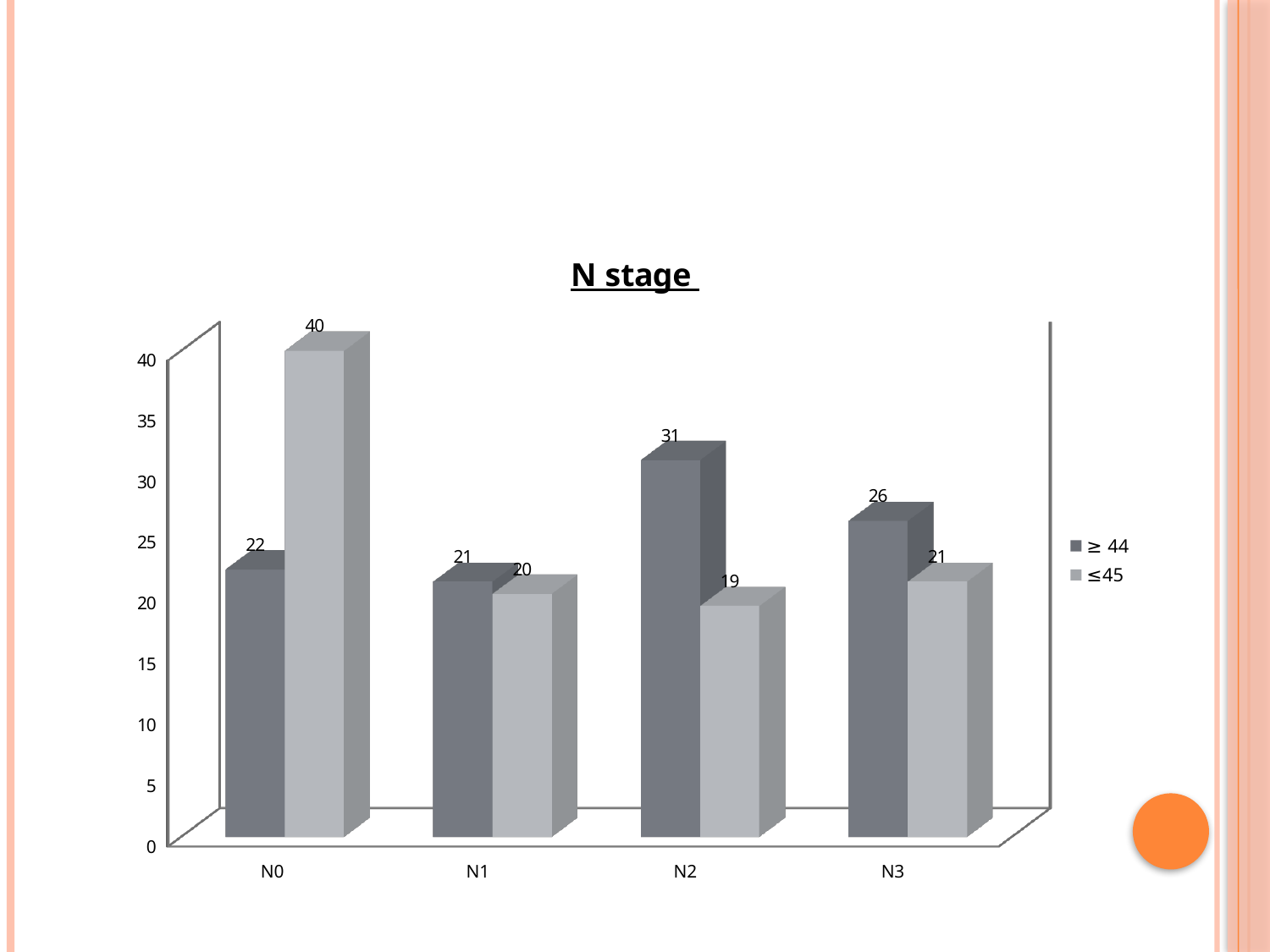
What is the value for N2 in the ≥ 44 series? 31 What is the value for N0 in the ≤45 series? 40 Which category has the highest value in the ≤45 series? N0 What is the difference between the ≤45 and ≥ 44 values for N0? 18 Which is larger for N2: the ≥ 44 value or the ≤45 value? ≥ 44 How many series does the legend list? 2 What kind of chart is shown on the slide? Bar chart What is the value for N0 in the ≥ 44 series? 22 What is the value for N3 in the ≤45 series? 21 Which category has the lowest value in the ≤45 series? N2 Which category has the highest value in the ≥ 44 series? N2 How many categories are shown on the x axis? 4